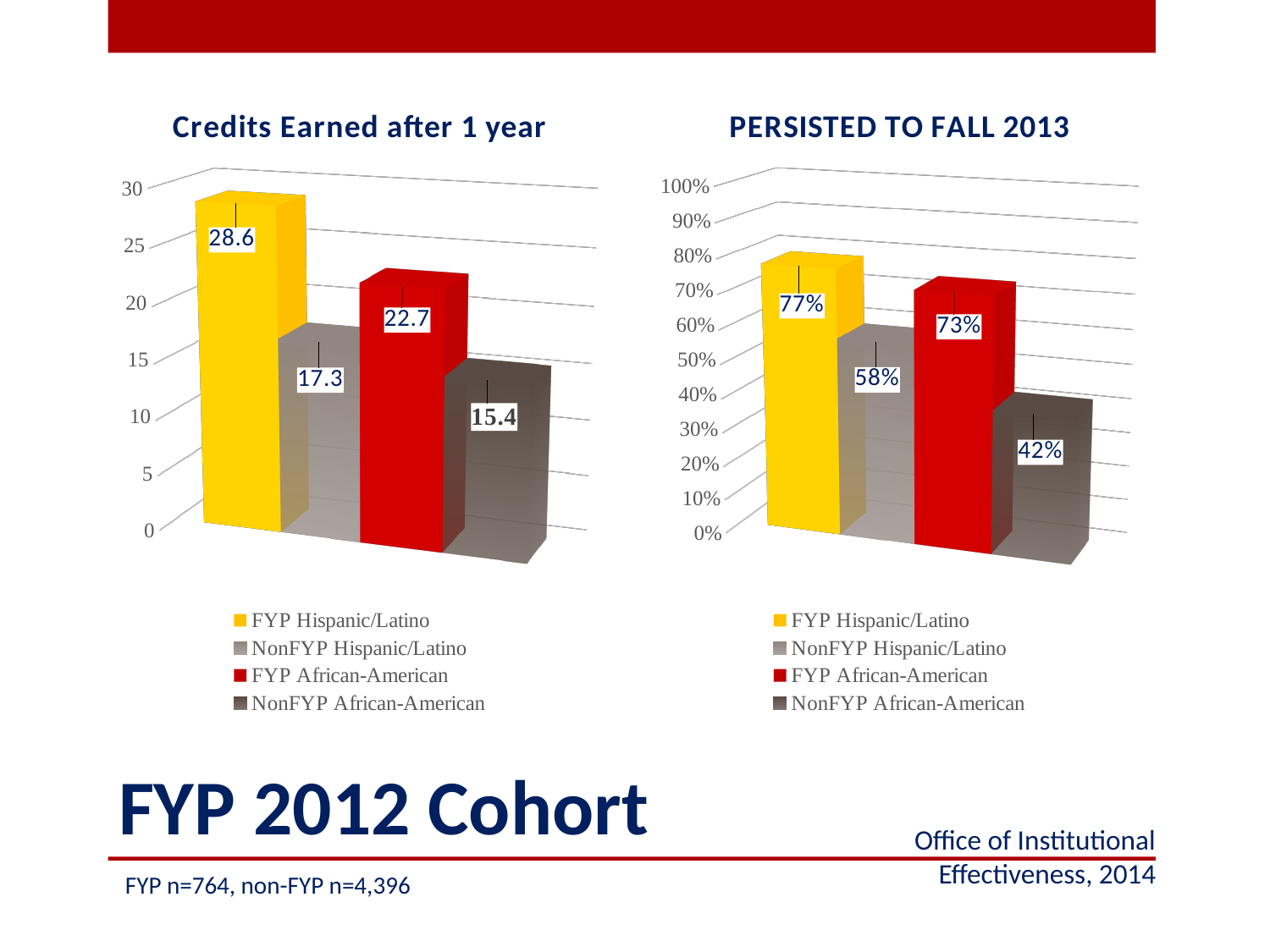
In the 'Credits Earned after 1 year' chart, which group has the highest value? FYP Hispanic/Latino In the 'PERSISTED TO FALL 2013' chart, what is the difference between FYP Hispanic/Latino and NonFYP Hispanic/Latino? 19% In the 'PERSISTED TO FALL 2013' chart, what is the value for FYP African-American? 73% What kind of chart is the 'Credits Earned after 1 year' chart? Bar chart How many series does the legend of the 'PERSISTED TO FALL 2013' chart list? 4 In the 'Credits Earned after 1 year' chart, what is the value for FYP Hispanic/Latino? 28.6 In the 'Credits Earned after 1 year' chart, what is the difference between FYP African-American and NonFYP African-American? 7.3 In the 'PERSISTED TO FALL 2013' chart, is the value for NonFYP African-American greater or less than 50%? less In the 'PERSISTED TO FALL 2013' chart, what is the value for NonFYP Hispanic/Latino? 58% In the 'Credits Earned after 1 year' chart, which is larger: NonFYP Hispanic/Latino or FYP African-American? FYP African-American In the 'Credits Earned after 1 year' chart, what is the value for NonFYP African-American? 15.4 In the 'PERSISTED TO FALL 2013' chart, which group has the lowest value? NonFYP African-American